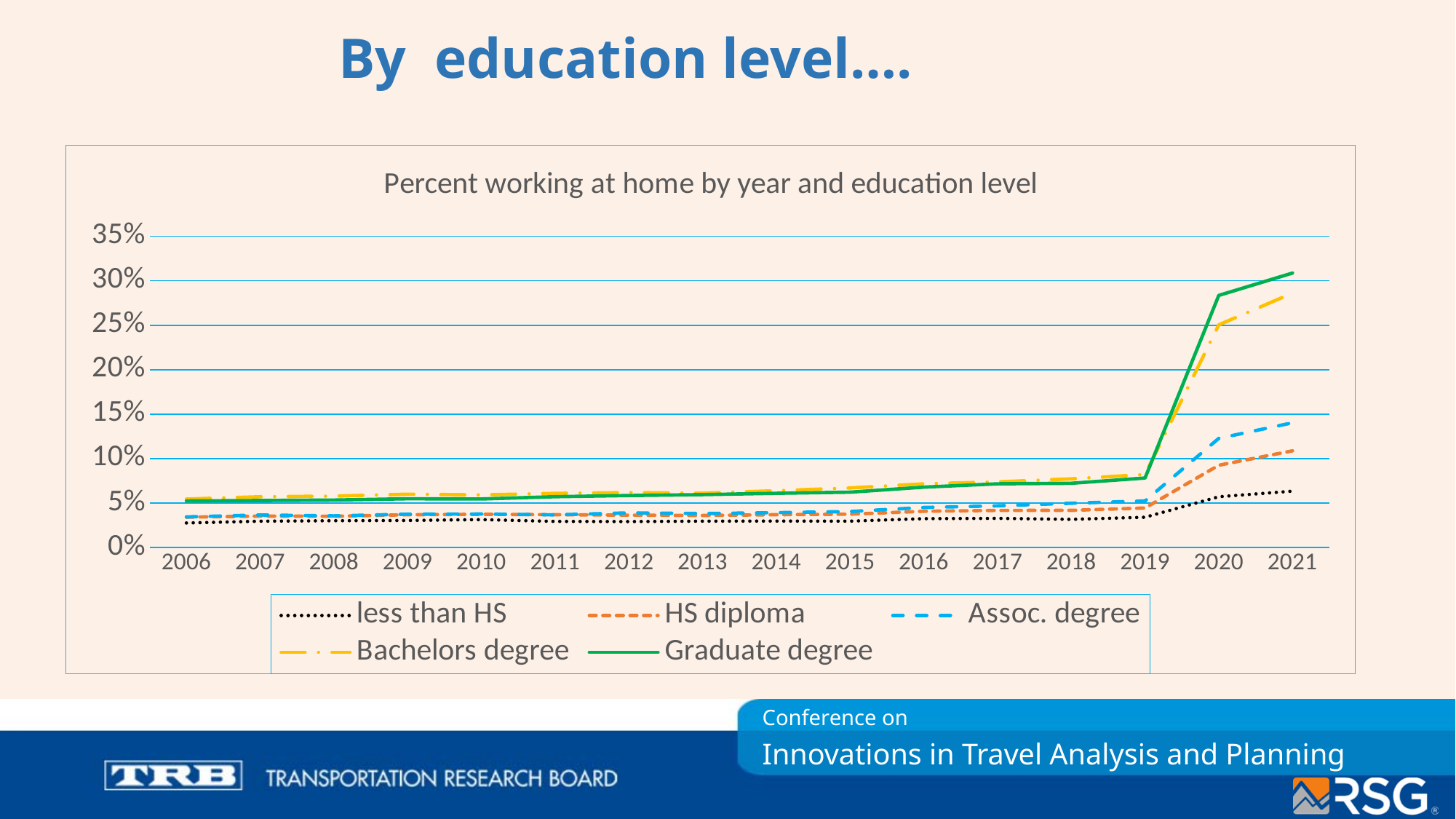
Which education level has the highest percent working at home in 2021? Graduate degree Does the Graduate degree line rise or fall between 2019 and 2021? rise How many series does the legend list? 5 Is the value for Bachelors degree in 2021 greater or less than 20%? greater In 2020, which is higher: Graduate degree or Bachelors degree? Graduate degree How many years are shown on the x axis? 16 Is the value for Assoc. degree in 2021 greater or less than 10%? greater Is the value for HS diploma in 2006 greater or less than 5%? less Which education level has the lowest percent working at home in 2021? less than HS What kind of chart is shown on the slide? line chart